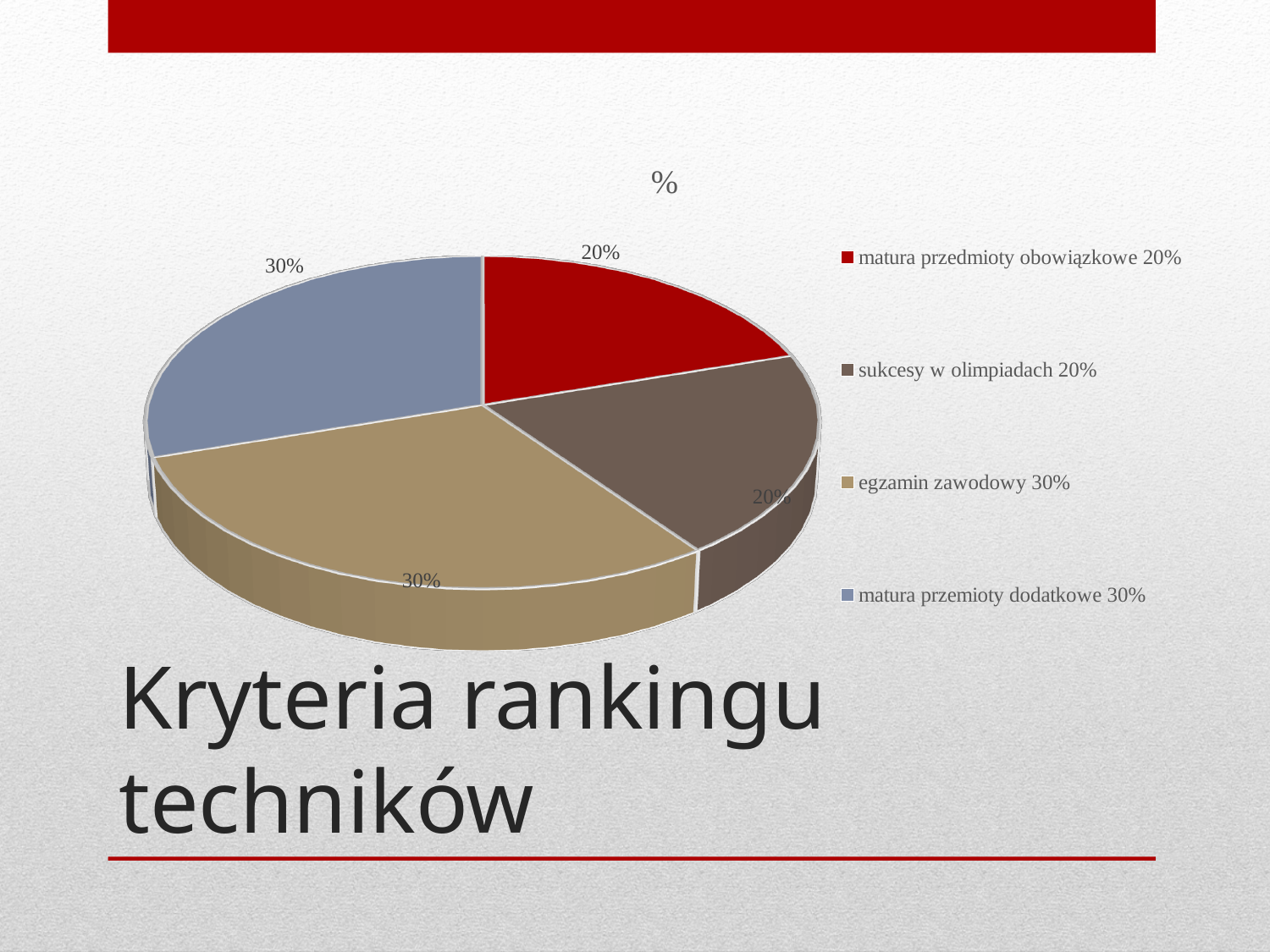
How many slices does the pie chart have? 4 How many entries does the legend list? 4 What is the difference between the share for 'egzamin zawodowy' and the share for 'matura przedmioty obowiązkowe'? 10% What is the chart's title? % What kind of chart is shown on the slide? pie chart What is the value shown for 'matura przemioty dodatkowe'? 30% Which colour represents 'matura przedmioty obowiązkowe' in the legend? red Which is larger, 'egzamin zawodowy' or 'sukcesy w olimpiadach'? egzamin zawodowy What share of the pie is 'sukcesy w olimpiadach'? 20% What is the value shown for 'matura przedmioty obowiązkowe'? 20% What share of the pie is 'egzamin zawodowy'? 30% Which is larger, 'matura przedmioty obowiązkowe' or 'matura przemioty dodatkowe'? matura przemioty dodatkowe